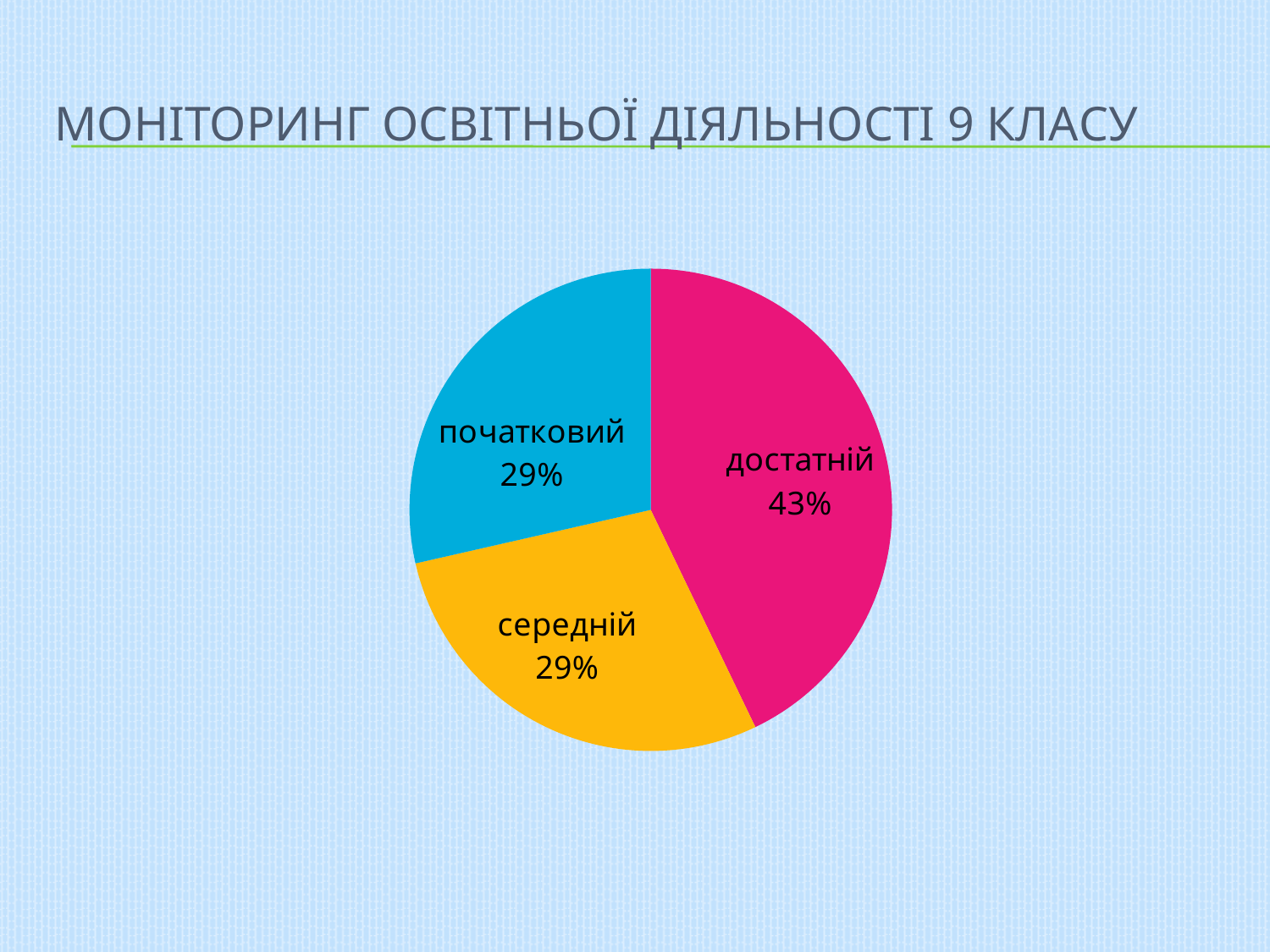
What share of the pie does the "середній" slice represent? 29% What kind of chart is shown on the slide? pie chart What share of the pie does the "початковий" slice represent? 29% How many slices does the pie chart have? 3 What is the title of the slide containing the pie chart? МОНІТОРИНГ ОСВІТНЬОЇ ДІЯЛЬНОСТІ 9 КЛАСУ Is the value for "достатній" greater or less than 40%? greater Which slice of the pie is the largest? достатній What colour is the "середній" slice of the pie? yellow What share of the pie does the "достатній" slice represent? 43% What is the difference between the "достатній" share and the "середній" share? 14% Which is larger, the "достатній" slice or the "початковий" slice? достатній